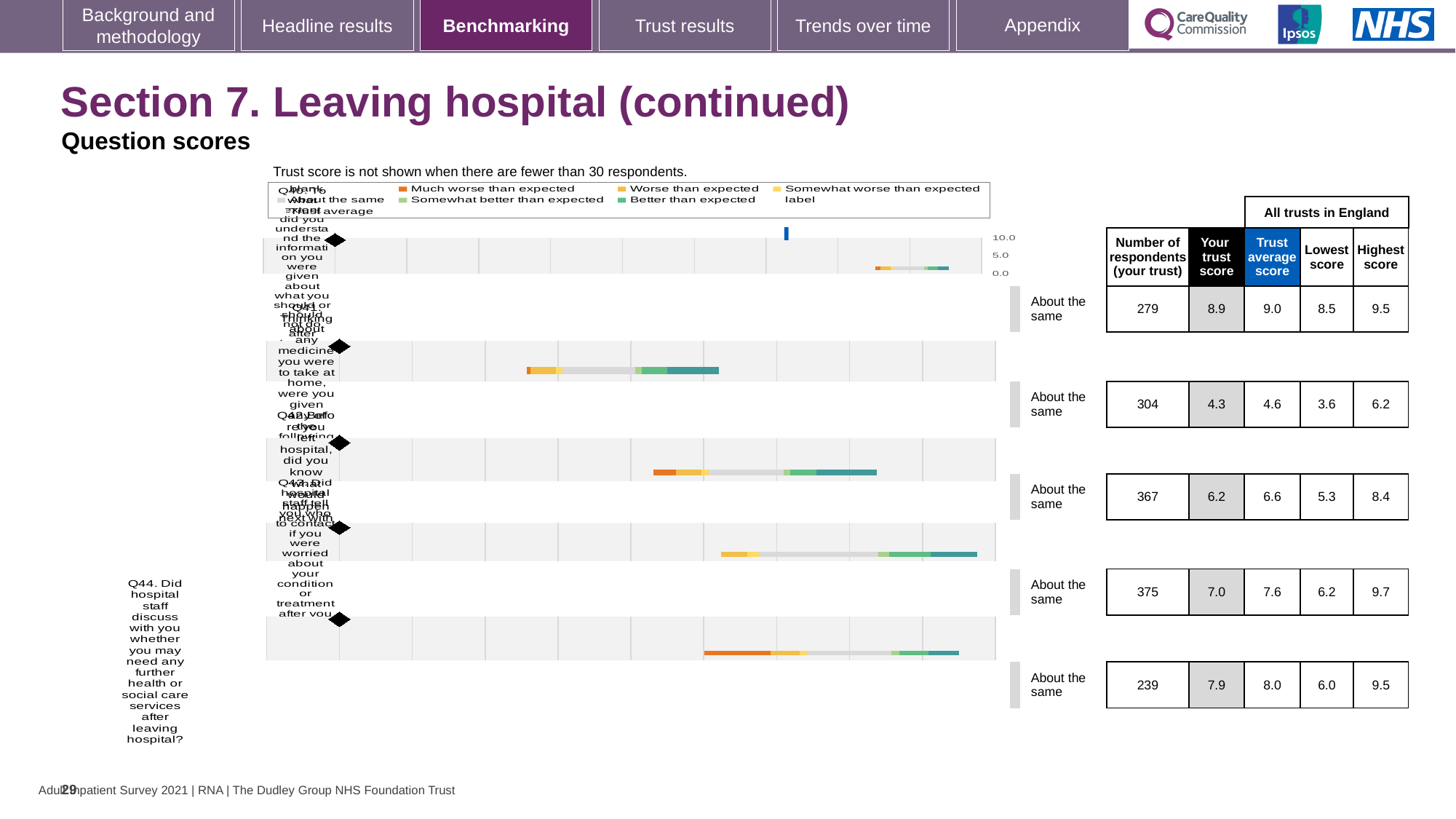
What benchmark category label is shown next to each question row? About the same What is the lowest 'Your trust score' value shown in the table? 4.3 In the table, what is the number of respondents (your trust) for Q44 (the last row)? 239 How many question rows are shown in the benchmarking chart and table? 5 What is the highest 'Your trust score' value shown in the table? 8.9 For Q44 (the last row), what is the difference between the 'Trust average score' and 'Your trust score'? 0.1 In the table, what is the 'Highest score' for Q44 (the last row)? 9.5 In the table, what is the number of respondents (your trust) for the third row? 367 For Q44 (the last row), is 'Your trust score' higher or lower than the 'Trust average score'? lower What kind of chart is used to show the question scores? bar chart In the table, what is the 'Trust average score' for Q44 (the last row)? 8.0 In the table, what is 'Your trust score' for Q44 (the last row)? 7.9